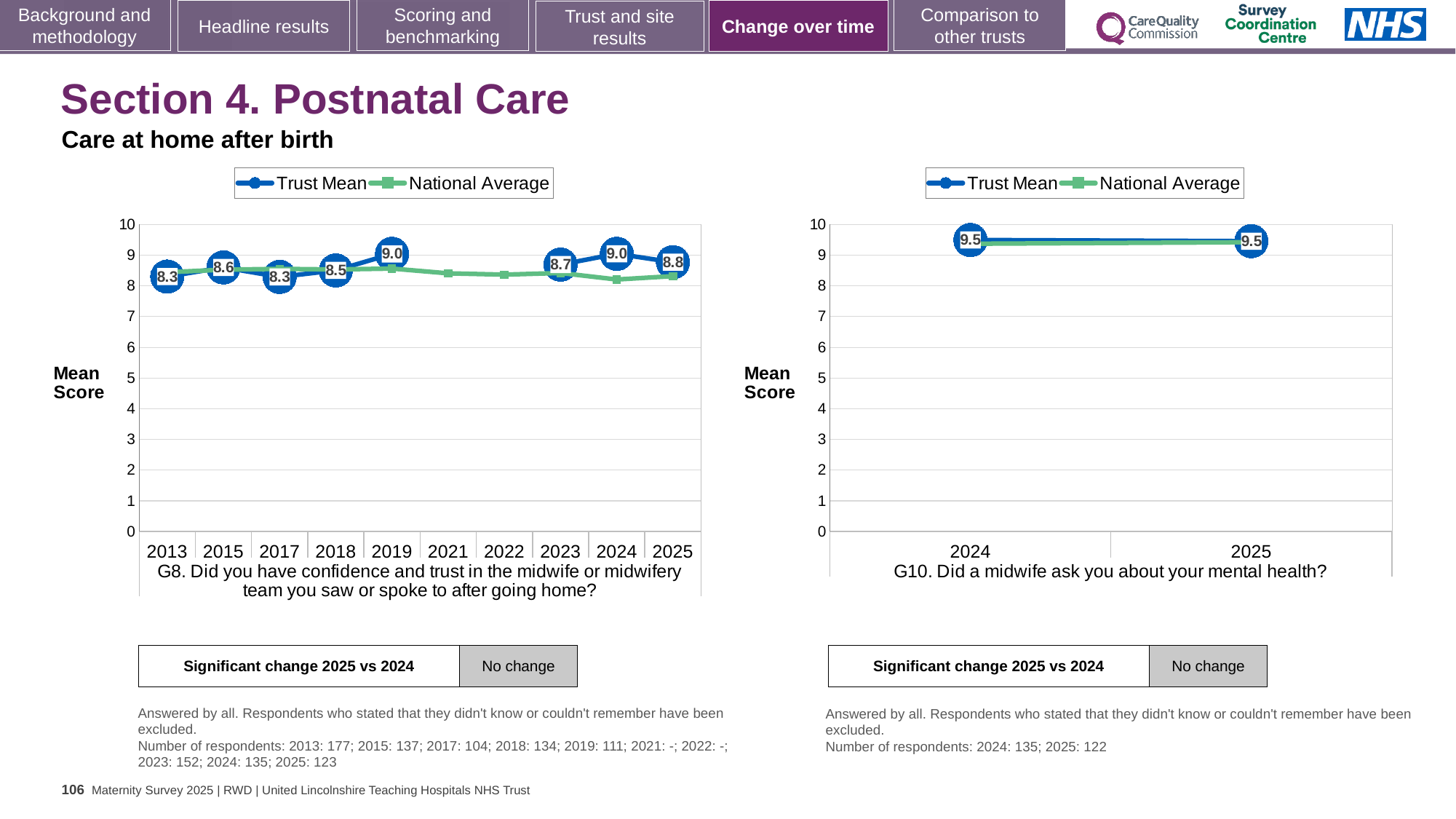
How many years are shown on the x axis of the left chart (G8)? 10 On the left chart (G8), what is the Trust Mean score for 2013? 8.3 What are the two series named in the legend of the right chart (G10)? Trust Mean and National Average On the left chart (G8), what is the Trust Mean score for 2019? 9.0 On the left chart (G8), is the National Average value for 2021 greater or less than 8? greater On the left chart (G8), what is the Trust Mean score for 2025? 8.8 What kind of chart is the right chart (G10)? Line chart On the right chart (G10), what is the Trust Mean score for 2024? 9.5 How many series does the legend of the left chart (G8) list? 2 On the left chart (G8), what is the difference between the Trust Mean scores for 2024 and 2025? 0.2 On the left chart (G8), which year has the higher Trust Mean score, 2015 or 2017? 2015 On the left chart (G8), what is the difference between the Trust Mean scores for 2024 and 2023? 0.3